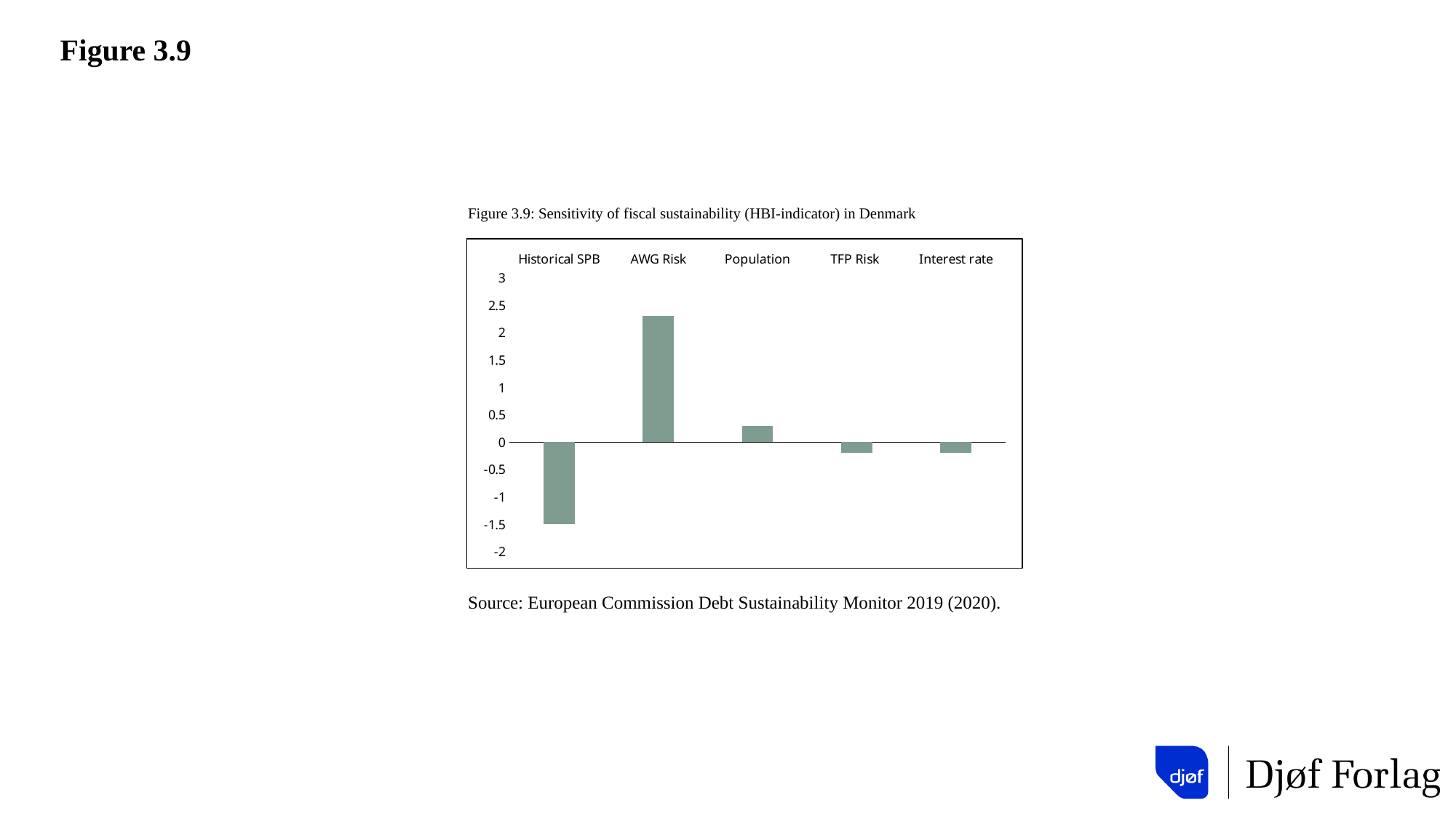
Which category has the highest value in the chart? AWG Risk Is the value for Population greater or less than 0.5? less How many categories are plotted in the chart? 5 Is the value for TFP Risk greater or less than 0? less What kind of chart is shown in Figure 3.9? bar chart Which is larger, the value for Population or the value for AWG Risk? AWG Risk What is the source cited below the chart? European Commission Debt Sustainability Monitor 2019 (2020) Which category has the lowest value in the chart? Historical SPB Is the value for AWG Risk greater or less than 2? greater What is the title of the chart? Figure 3.9: Sensitivity of fiscal sustainability (HBI-indicator) in Denmark Which is larger, the value for Population or the value for Interest rate? Population